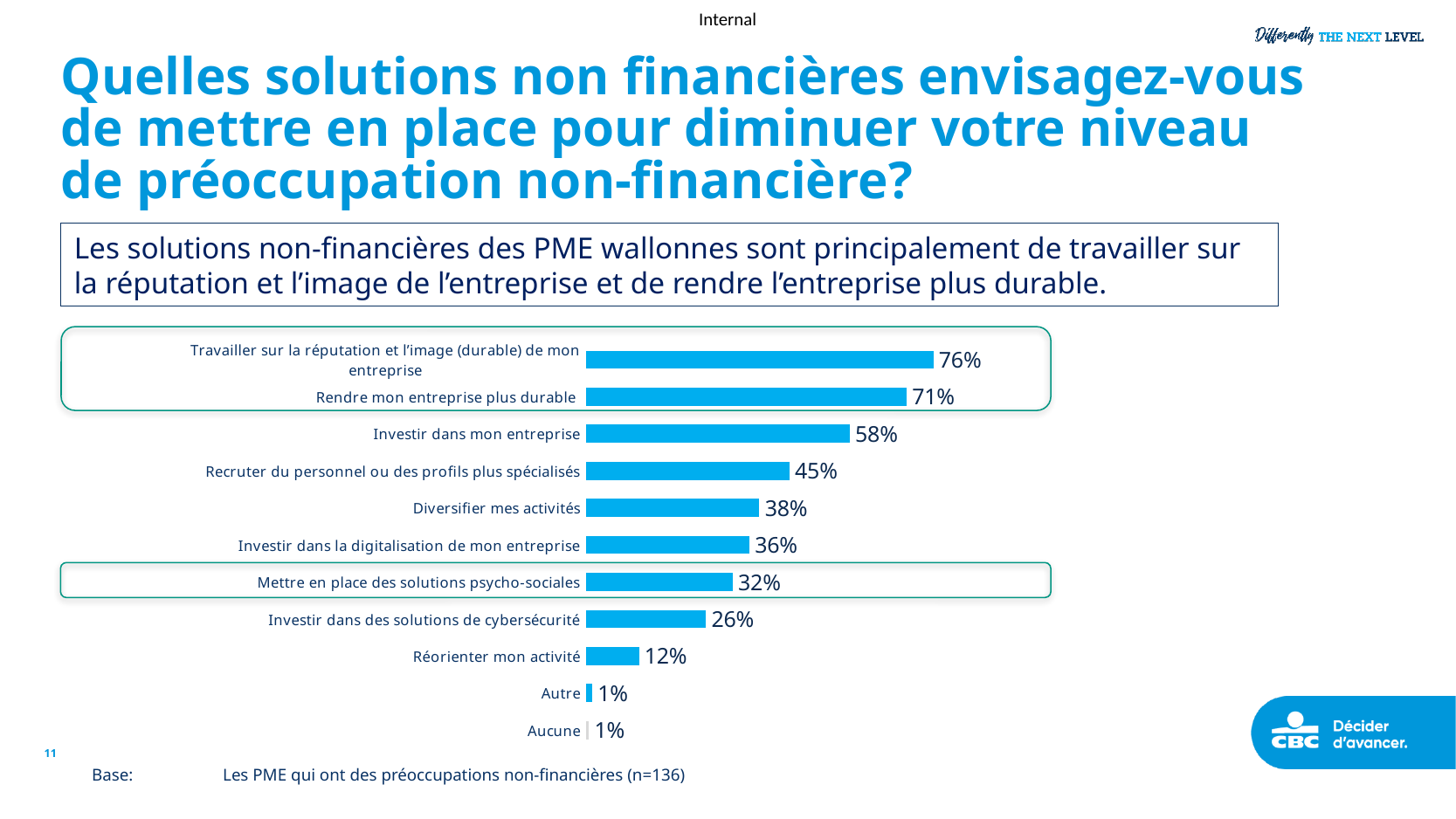
What is the difference between the highest value and "Rendre mon entreprise plus durable"? 5% What is the value for "Autre"? 1% What is the base (n) stated below the chart? n=136 How many categories are shown in the chart? 11 What kind of chart is shown on the slide? Bar chart Which category has the highest value? Travailler sur la réputation et l'image (durable) de mon entreprise What is the value for "Réorienter mon activité"? 12% Which is larger: "Investir dans la digitalisation de mon entreprise" or "Mettre en place des solutions psycho-sociales"? Investir dans la digitalisation de mon entreprise What is the value for "Investir dans des solutions de cybersécurité"? 26% What is the difference between "Investir dans mon entreprise" and "Recruter du personnel ou des profils plus spécialisés"? 13% What is the value for "Diversifier mes activités"? 38% What is the value for "Rendre mon entreprise plus durable"? 71%